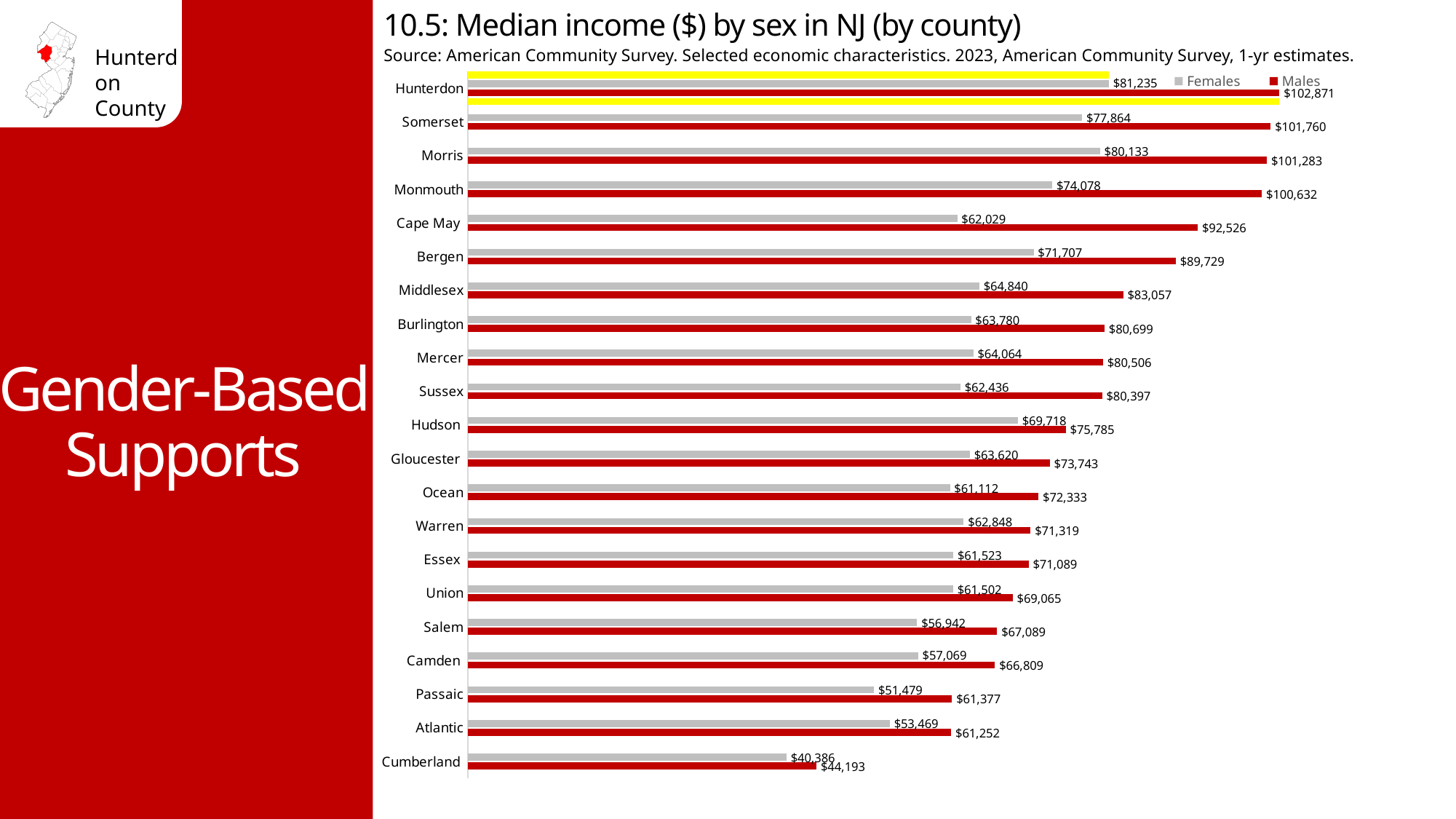
What is the median income for females in Somerset County? $77,864 Which county has the highest median income for males? Hunterdon How many series does the legend list? 2 What is the difference between the male and female median incomes in Hunterdon County? $21,636 How many counties are shown in the chart? 21 What is the median income for females in Cumberland County? $40,386 What kind of chart is shown on the slide? Bar chart What is the median income for males in Cape May County? $92,526 What is the difference between the male and female median incomes in Cumberland County? $3,807 What is the median income for males in Hunterdon County? $102,871 Which county has the lowest median income for females? Cumberland Which is larger, the female median income in Morris County or in Monmouth County? Morris